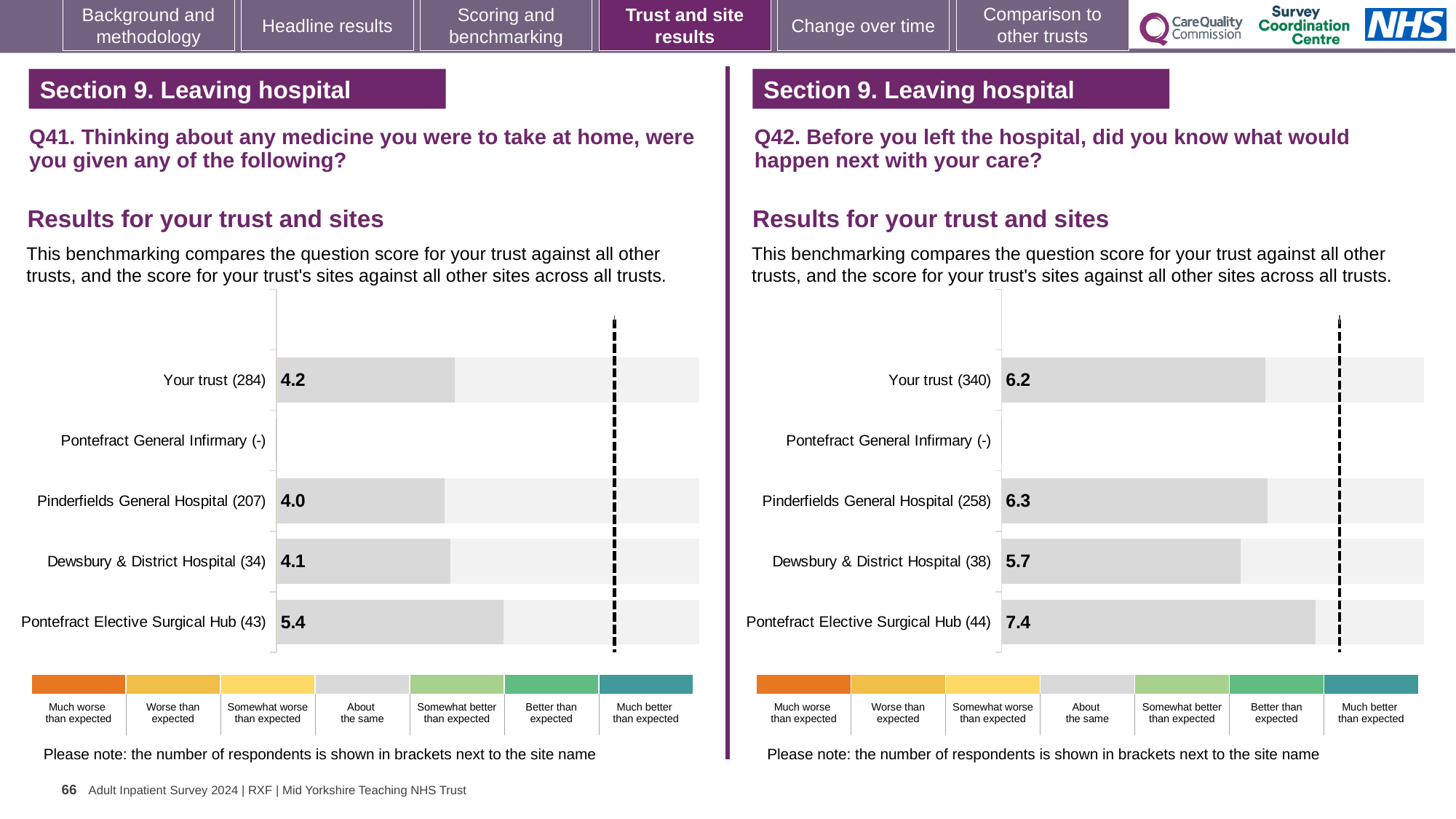
On the Q42 chart (right), how many rows (trust and sites) are listed on the vertical axis? 5 On the Q41 chart (left), what is the score for Your trust? 4.2 On the Q42 chart (right), what is the score for Dewsbury & District Hospital? 5.7 On the Q42 chart (right), which is larger, the score for Pinderfields General Hospital or the score for Pontefract Elective Surgical Hub? Pontefract Elective Surgical Hub On the Q42 chart (right), what is the difference between the scores for Pontefract Elective Surgical Hub and Your trust? 1.2 On the Q41 chart (left), which site has the highest score? Pontefract Elective Surgical Hub On the Q41 chart (left), what is the difference between the scores for Pontefract Elective Surgical Hub and Pinderfields General Hospital? 1.4 On the Q42 chart (right), what is the score for Your trust? 6.2 On the Q41 chart (left), what is the score for Pontefract Elective Surgical Hub? 5.4 On the Q42 chart (right), which site has the lowest score among those with a bar shown? Dewsbury & District Hospital On the Q41 chart (left), how many respondents are shown for Dewsbury & District Hospital? 34 What kind of chart is used on the Q41 chart (left)? Bar chart